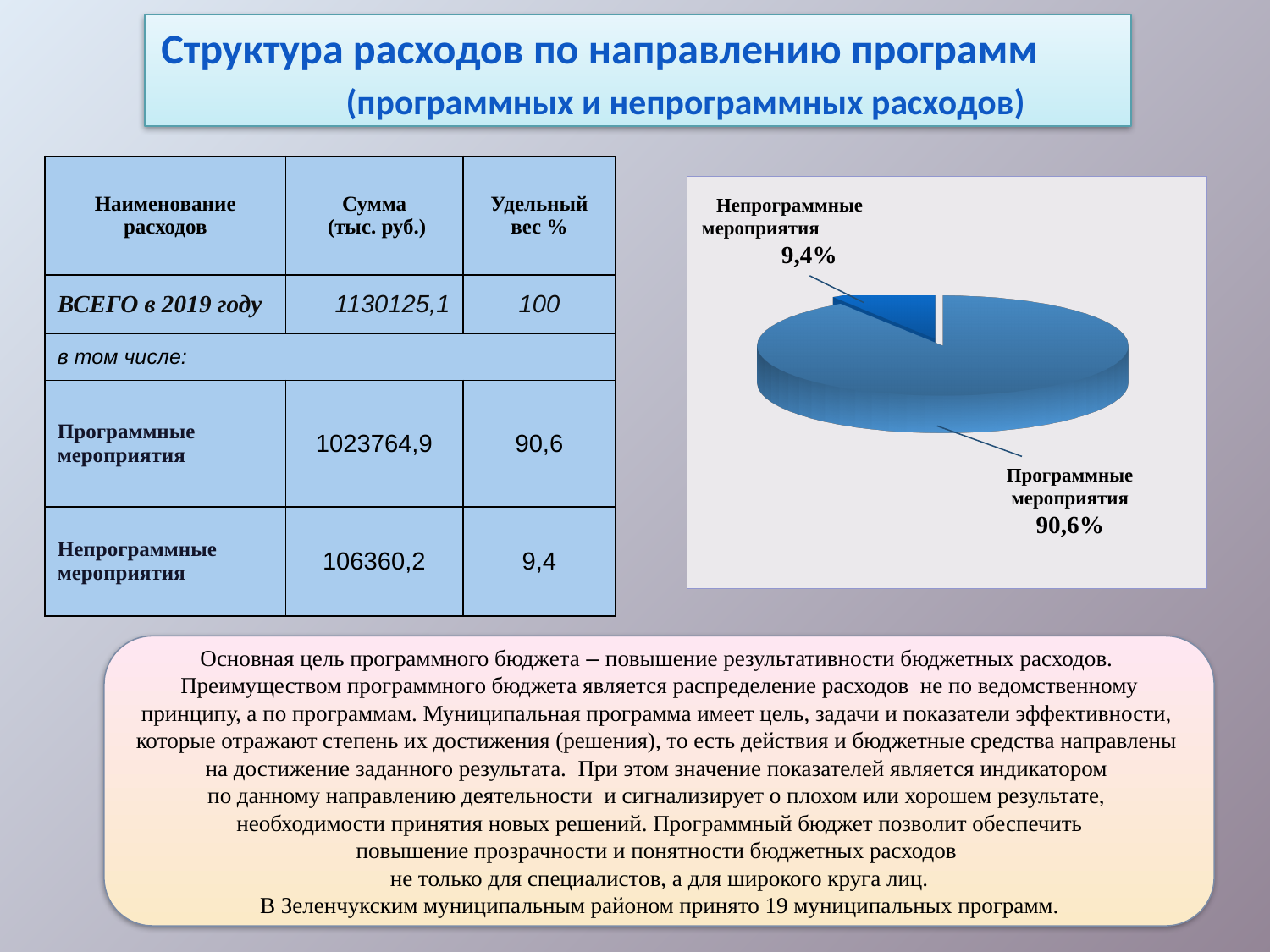
Which slice of the pie chart is pulled out (exploded) from the rest? Непрограммные мероприятия What kind of chart is shown on the slide? pie chart By how many percentage points does the Программные мероприятия slice exceed the Непрограммные мероприятия slice? 81,2 What share of the pie does the Непрограммные мероприятия slice represent? 9,4% How many slices does the pie chart have? 2 Which category has the largest slice in the pie chart? Программные мероприятия Which category has the smallest slice in the pie chart? Непрограммные мероприятия What percentage does the pie chart show for Программные мероприятия? 90,6% What do the two slice percentages in the pie chart add up to? 100% Which slice is larger in the pie chart: Программные мероприятия or Непрограммные мероприятия? Программные мероприятия What is the title of the slide containing the pie chart? Структура расходов по направлению программ (программных и непрограммных расходов) What percentage does the pie chart show for Непрограммные мероприятия? 9,4%